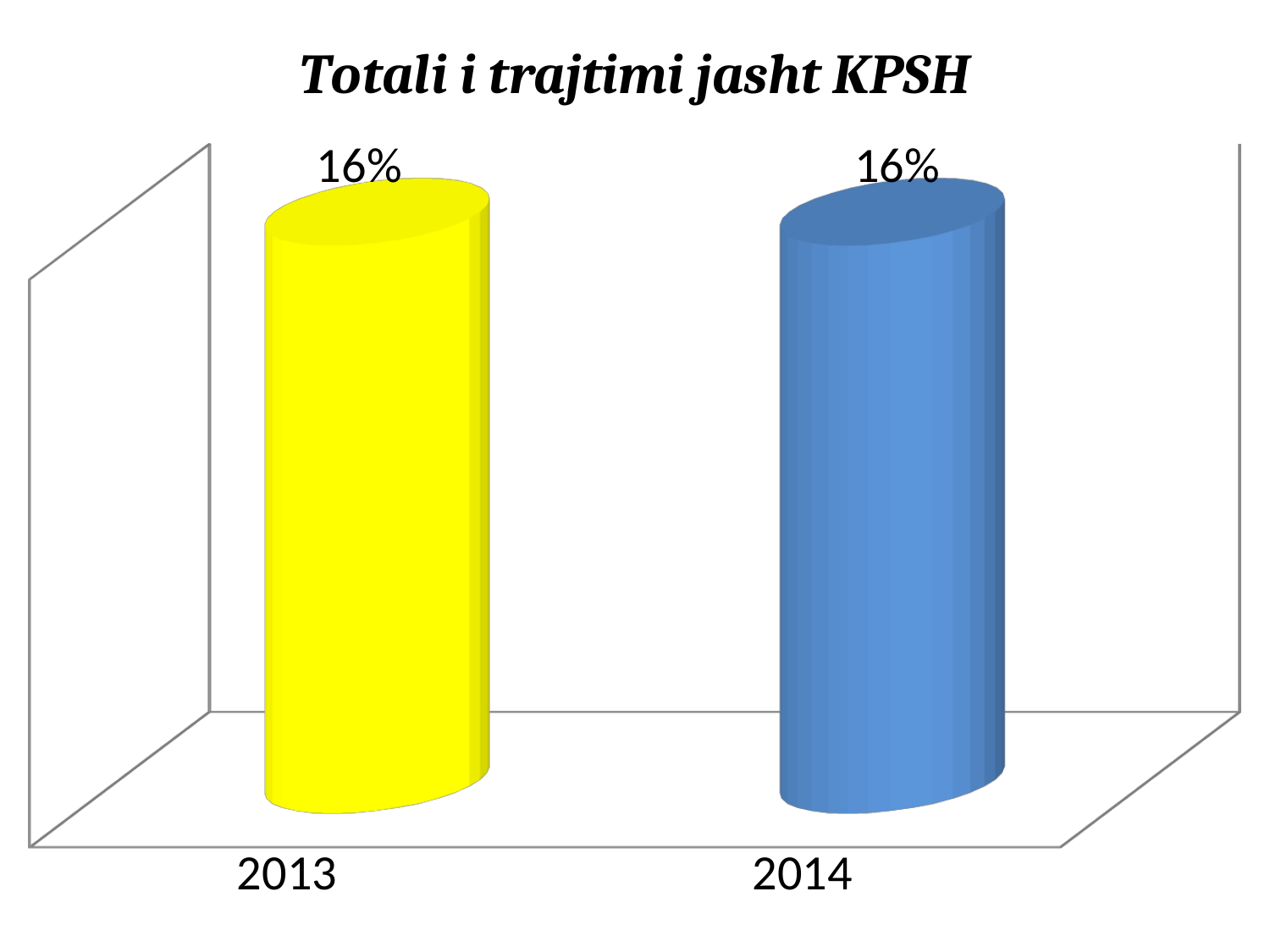
What is the value for 2014? 16% How many categories are shown on the x axis? 2 Which years are shown as categories on the x axis? 2013 and 2014 What is the title of the chart? Totali i trajtimi jasht KPSH Do the values rise, fall or stay the same from 2013 to 2014? stay the same What is the difference between the values for 2013 and 2014? 0% What colour is the bar for 2013? yellow What is the value for 2013? 16% What kind of chart is shown on the slide? bar chart